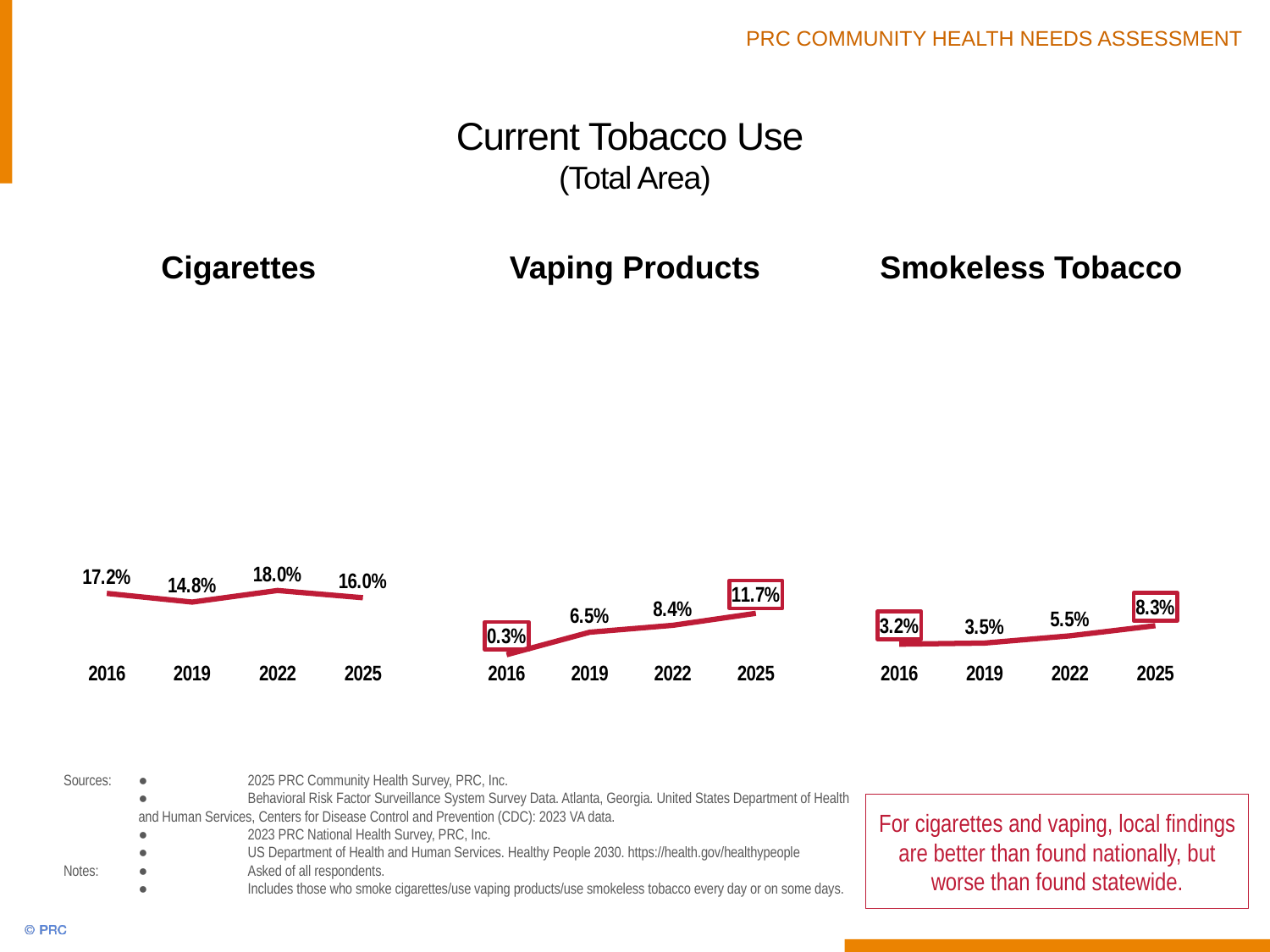
In the Cigarettes chart, which is larger, the value for 2016 or the value for 2025? 2016 In the Cigarettes chart, which year has the lowest value? 2019 What is the title of the slide's charts? Current Tobacco Use (Total Area) In the Vaping Products chart, what is the value for 2016? 0.3% In the Smokeless Tobacco chart, what is the difference between the 2025 and 2016 values? 5.1% How many data points are plotted in the Smokeless Tobacco chart? 4 In the Vaping Products chart, what is the difference between the 2025 and 2022 values? 3.3% In the Vaping Products chart, which year has the highest value? 2025 In the Vaping Products chart, do the values rise or fall from 2016 to 2025? Rise In the Smokeless Tobacco chart, what is the value for 2025? 8.3% What kind of chart is the Vaping Products chart? Line chart In the Cigarettes chart, what is the value for 2022? 18.0%